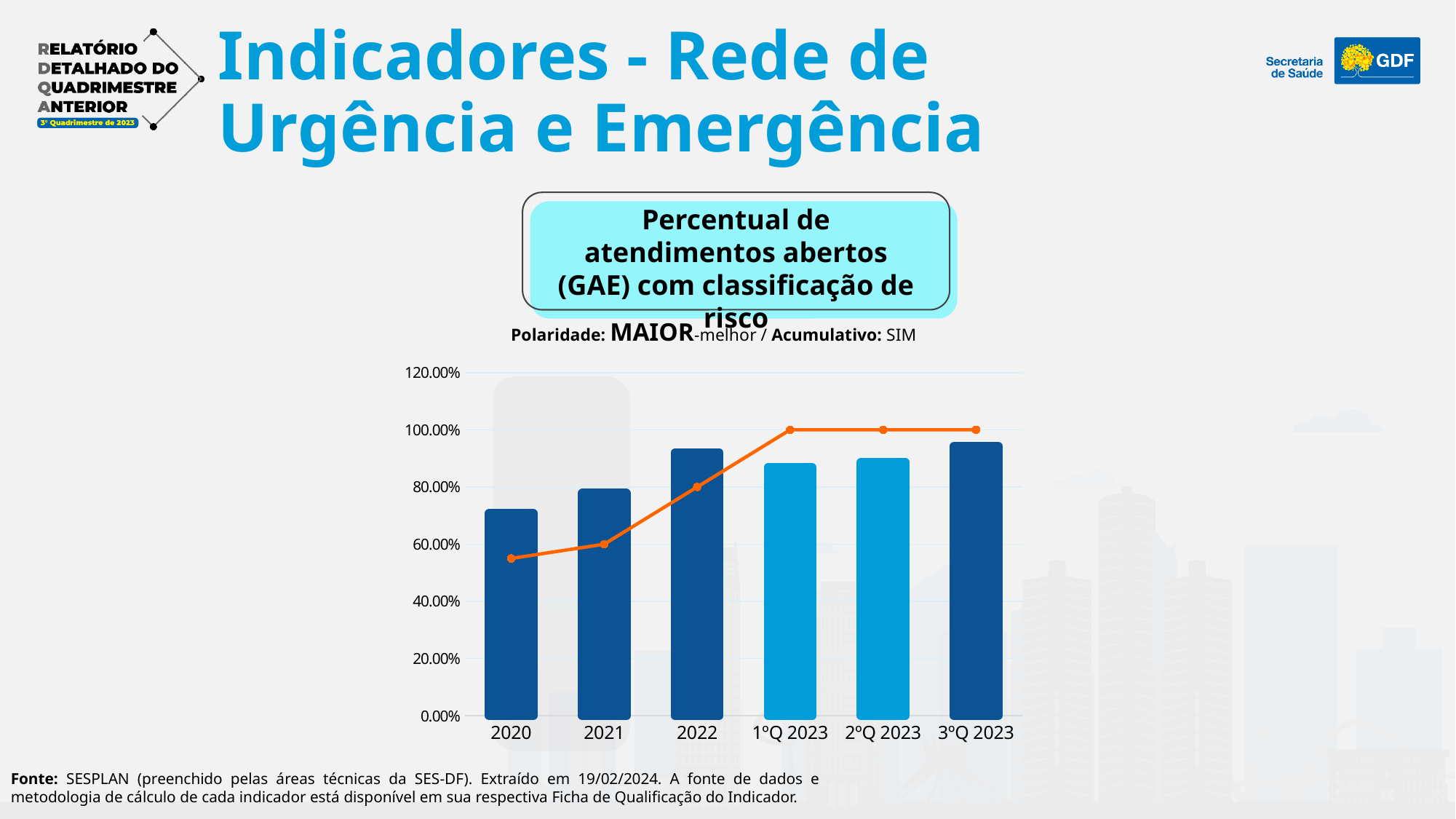
What kind of chart is shown on the slide? combination bar and line chart Is the orange line value for 2020 greater or less than 60.00%? less Is the bar value for 2021 greater or less than 60.00%? greater Is the bar value for 2020 greater or less than 80.00%? less Which category has the lowest bar in the chart? 2020 What is the title of the indicator shown above the chart? Percentual de atendimentos abertos (GAE) com classificação de risco What polarity (Polaridade) is stated for the indicator? MAIOR-melhor Which has the taller bar, 2021 or 2022? 2022 Do the bar values rise or fall from 2020 to 2022? rise How many categories are shown on the x axis of the chart? 6